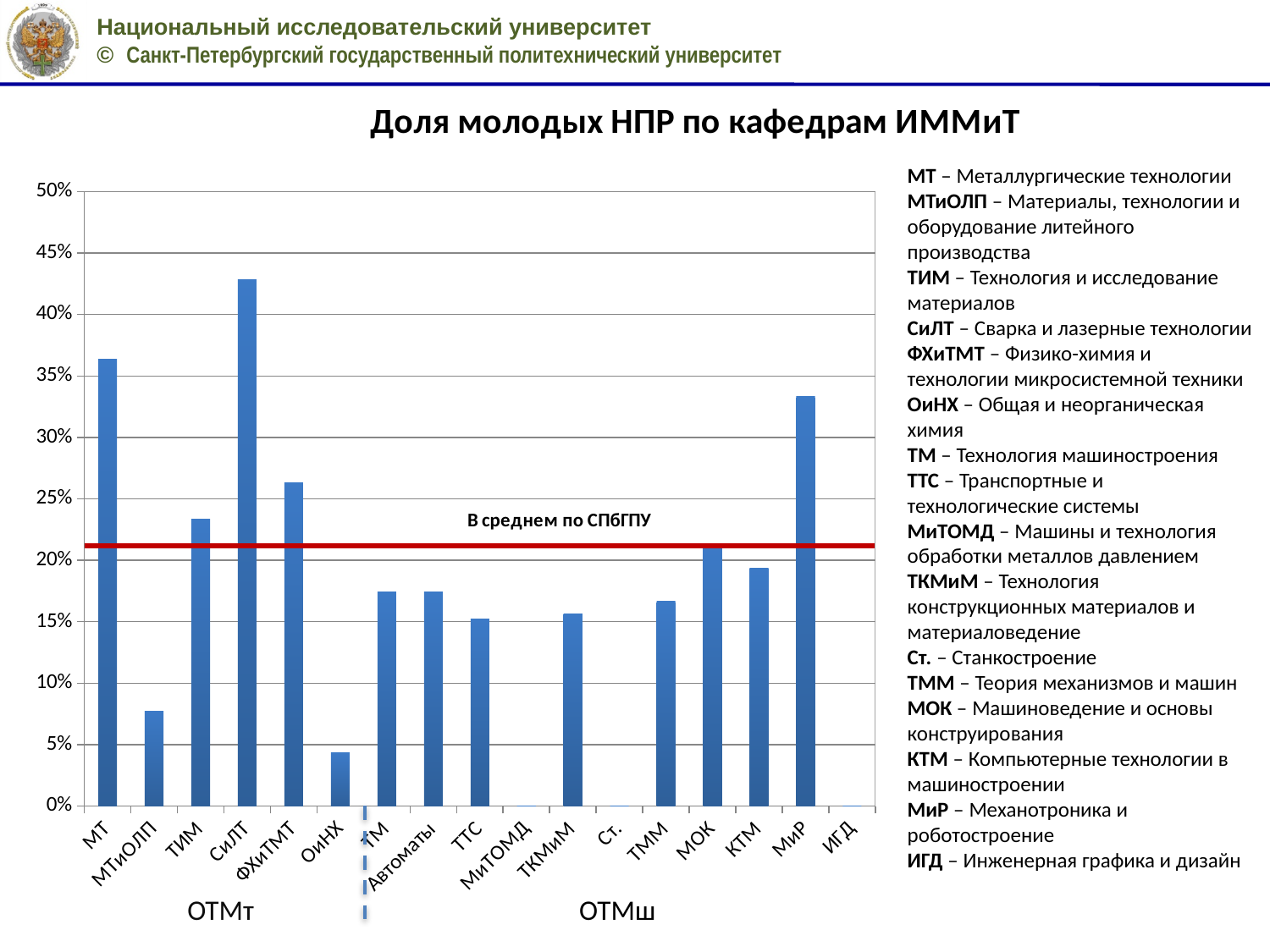
Is the value for МТ greater or less than 35%? greater Which department has the highest share of young researchers in the chart? СиЛТ How many departments (categories) are shown on the x axis of the chart? 17 Which is larger, the value for МТ or the value for ТИМ? МТ Is the value for МТиОЛП greater or less than 10%? less What does the horizontal red line on the chart represent, according to its label? В среднем по СПбГПУ What is the title of the chart? Доля молодых НПР по кафедрам ИММиТ Is the value for СиЛТ greater or less than 40%? greater Which is larger, the value for ТТС or the value for КТМ? КТМ What kind of chart is shown on the slide? bar chart